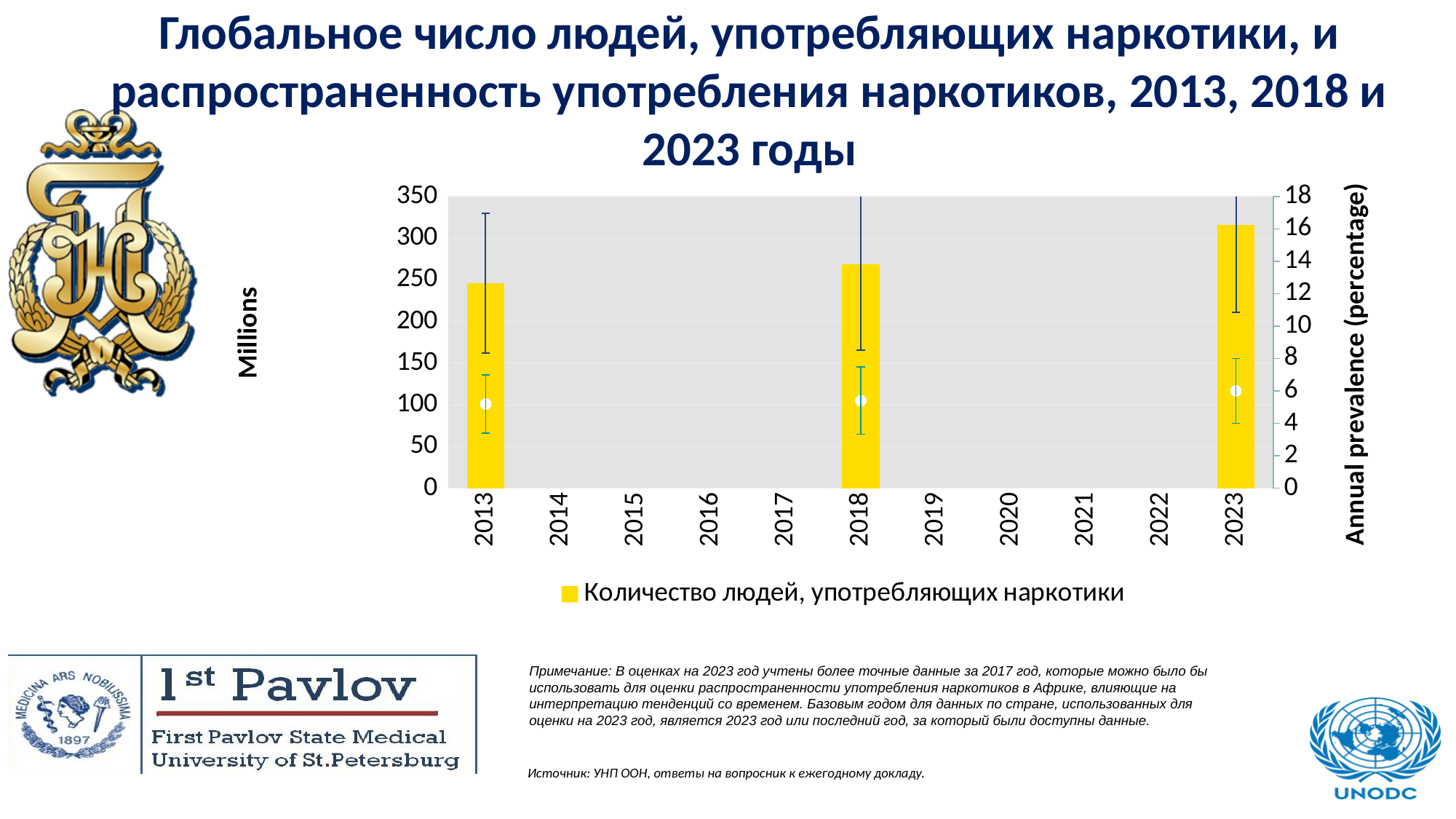
Do the bar values rise or fall from 2013 to 2023? rise Is the bar value for 2018 greater or less than 200 million? greater Is the bar value for 2013 greater or less than 200 million? greater What is the label of the right-hand vertical axis? Annual prevalence (percentage) Which year has the lowest bar for the number of people using drugs? 2013 How many bars are plotted in the chart? 3 Which bar is taller, 2018 or 2013? 2018 What kind of chart is shown on the slide? bar chart Is the bar value for 2013 greater or less than 300 million? less Which year has the highest bar for the number of people using drugs? 2023 How many series does the legend list? 1